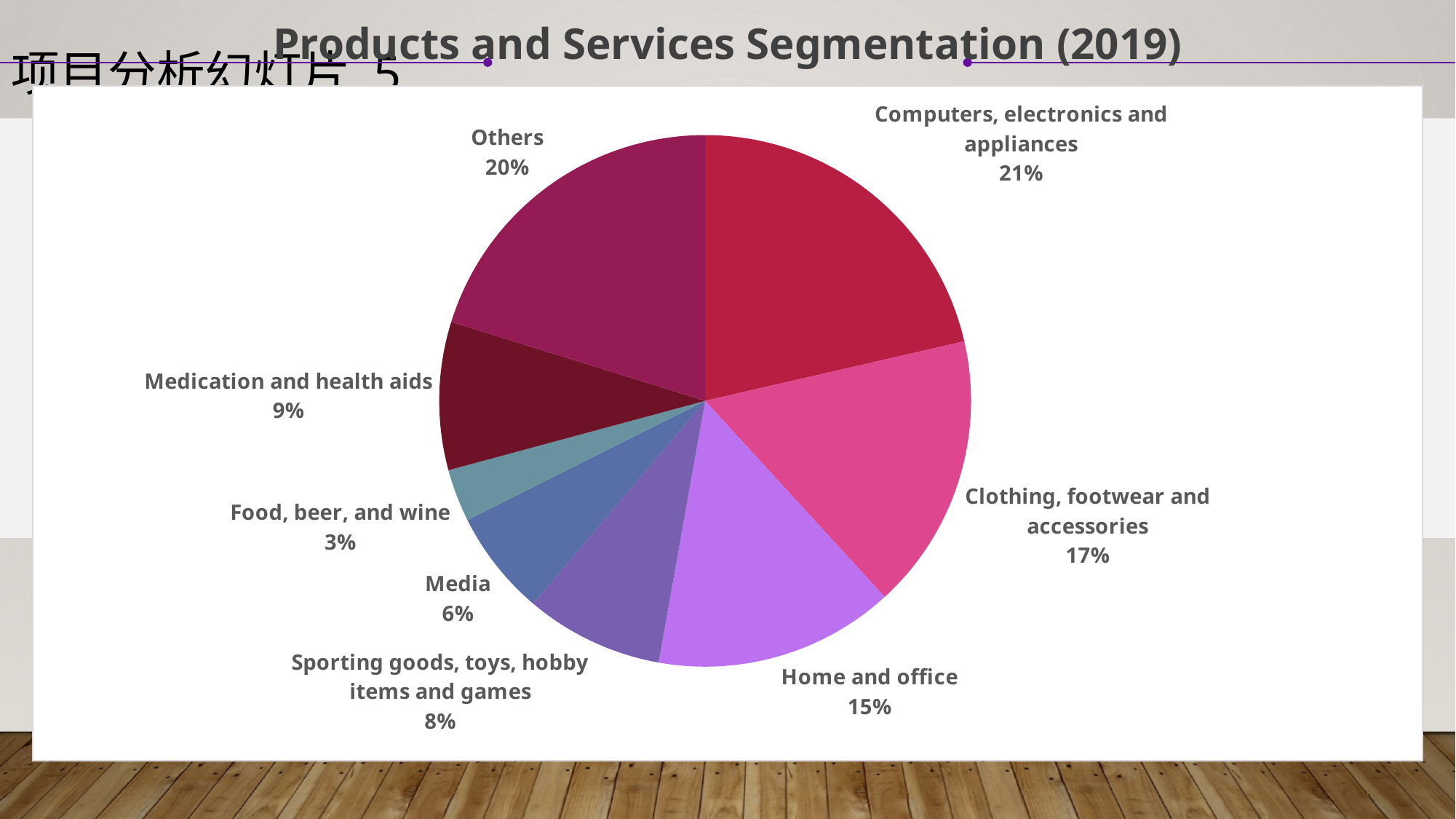
What share does Food, beer, and wine have? 3% Which is larger, Clothing, footwear and accessories or Home and office? Clothing, footwear and accessories What share does Home and office have? 15% What is the difference between the shares of Others and Medication and health aids? 11% What share does Sporting goods, toys, hobby items and games have? 8% What share does Computers, electronics and appliances have? 21% What is the title of the chart? Products and Services Segmentation (2019) Which category has the largest share? Computers, electronics and appliances What is the difference between the shares of Media and Food, beer, and wine? 3% Which category has the smallest share? Food, beer, and wine What kind of chart is shown on the slide? Pie chart How many categories are shown in the pie chart? 8